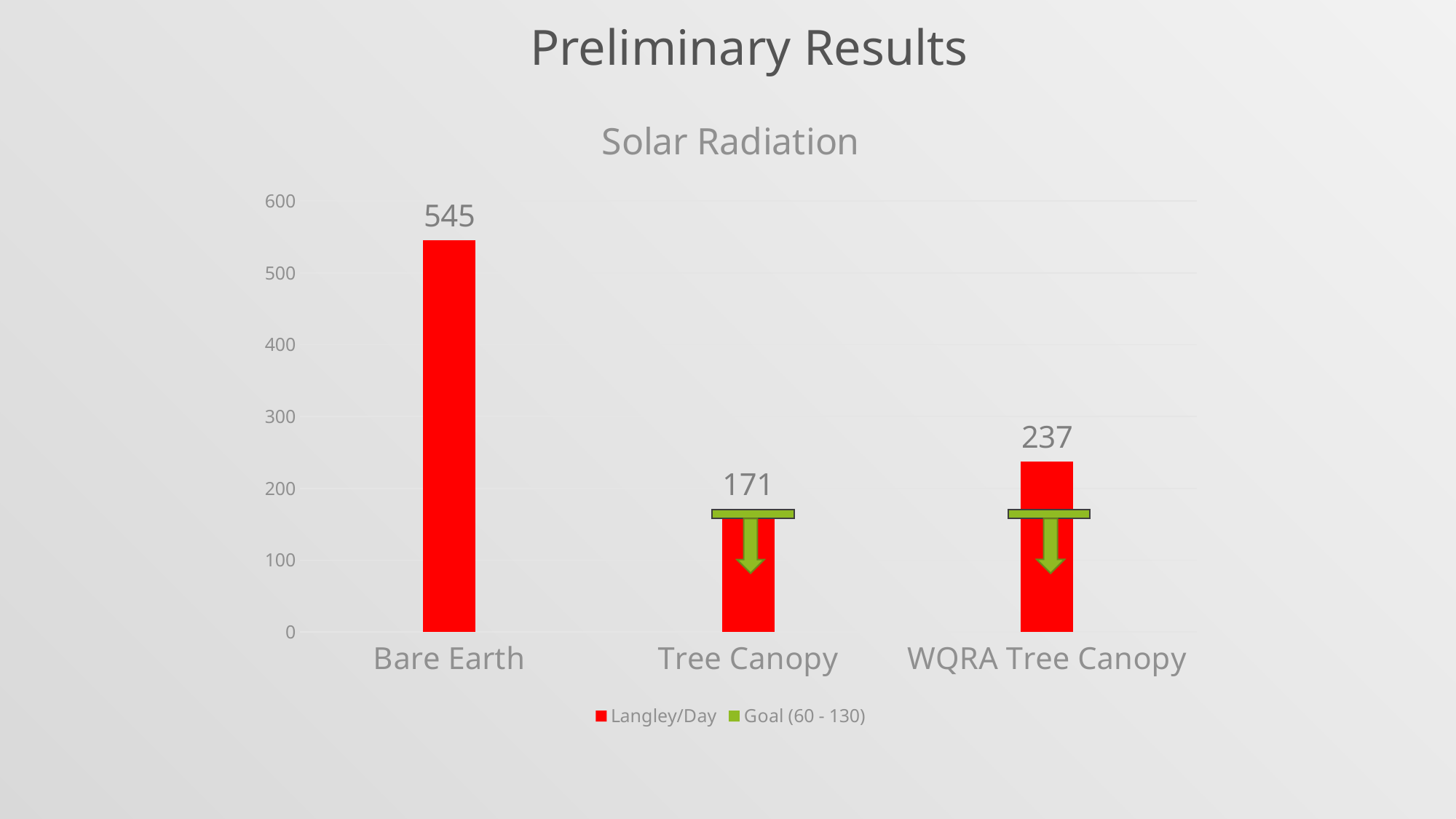
Is the Langley/Day value for Bare Earth greater or less than 500? greater Which has a larger Langley/Day value, Tree Canopy or WQRA Tree Canopy? WQRA Tree Canopy What is the difference between the Langley/Day values for WQRA Tree Canopy and Tree Canopy? 66 Which category has the lowest Langley/Day value? Tree Canopy What is the difference between the Langley/Day values for Bare Earth and Tree Canopy? 374 How many series does the legend list? 2 What is the Langley/Day value for WQRA Tree Canopy? 237 What is the Langley/Day value for Bare Earth? 545 How many categories are shown on the x axis? 3 What is the Langley/Day value for Tree Canopy? 171 What is the title of the chart? Solar Radiation Which category has the highest Langley/Day value? Bare Earth